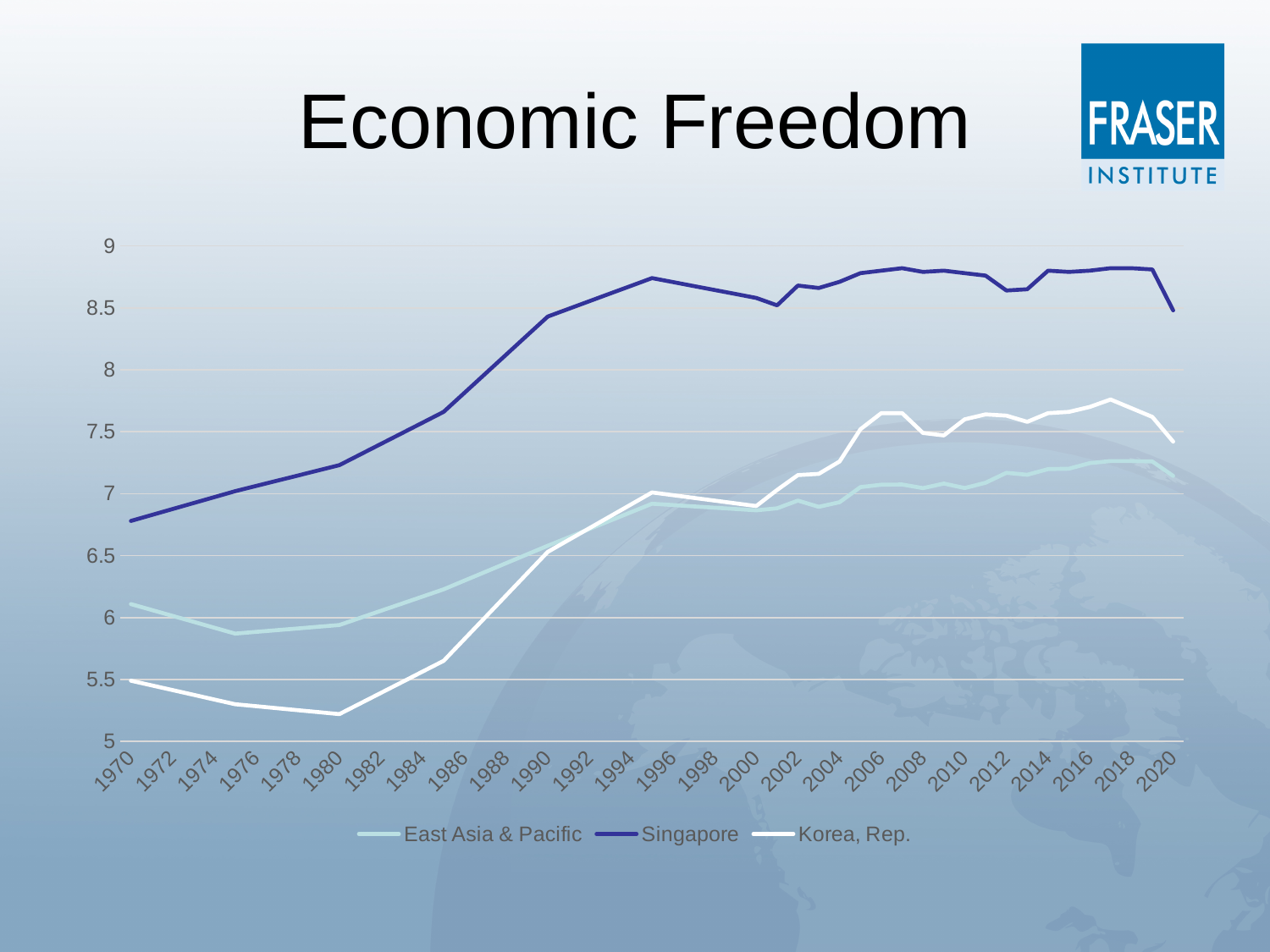
Is the value for Korea, Rep. in 1980 greater or less than 5.5? less In 2010, which is higher: Korea, Rep. or East Asia & Pacific? Korea, Rep. Which series has the highest value in 2016? Singapore What kind of chart is shown on the slide? line chart Is the value for Singapore in 1970 greater or less than 6.5? greater What is the title of the chart? Economic Freedom How many series does the legend list? 3 Is the value for East Asia & Pacific in 2018 greater or less than 7? greater In 1980, which is higher: East Asia & Pacific or Korea, Rep.? East Asia & Pacific Which series is drawn with the dark blue line? Singapore Does the Singapore line rise or fall between 1970 and 1995? rise Which series has the lowest value in 1970? Korea, Rep.